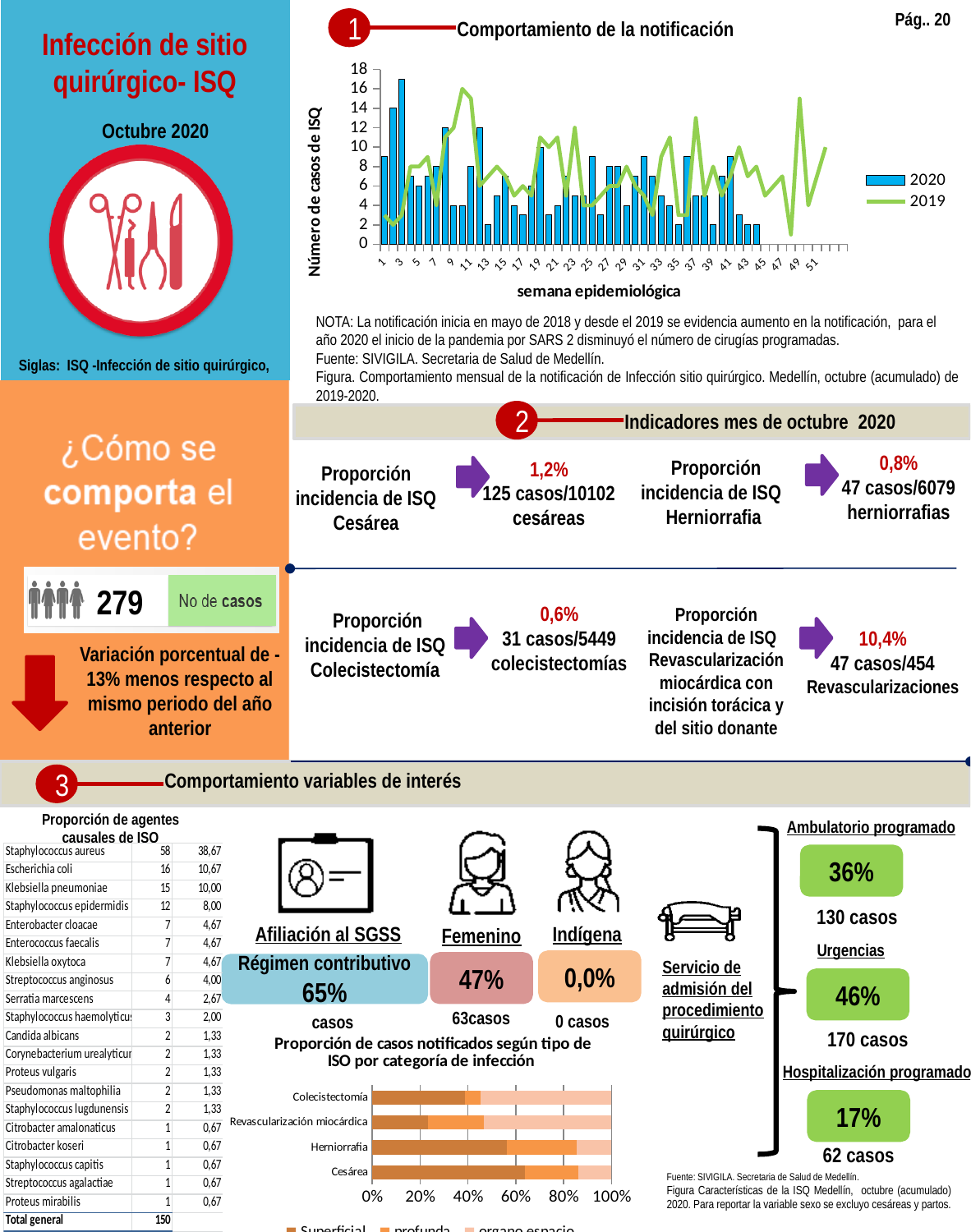
In the chart 'Comportamiento de la notificación', which is larger, the 2020 bar for week 3 or the 2020 bar for week 20? week 3 In the chart 'Comportamiento de la notificación', is the 2020 value for week 2 greater or less than 10? greater In the chart 'Comportamiento de la notificación', what is the label of the x axis? semana epidemiológica How many categories are shown in the chart 'Proporción de casos notificados según tipo de ISO por categoría de infección'? 4 How many series does the legend list in the chart 'Proporción de casos notificados según tipo de ISO por categoría de infección'? 3 What kind of chart is 'Proporción de casos notificados según tipo de ISO por categoría de infección'? stacked bar chart In the chart 'Comportamiento de la notificación', is the 2020 value for week 44 greater or less than 4? less In the chart 'Comportamiento de la notificación', which year is plotted as a line rather than bars? 2019 In the chart 'Comportamiento de la notificación', how many series does the legend list? 2 In the chart 'Proporción de casos notificados según tipo de ISO por categoría de infección', is the Superficial share for Revascularización miocárdica greater or less than 40%? less In the chart 'Comportamiento de la notificación', which epidemiological week has the highest 2020 bar? 3